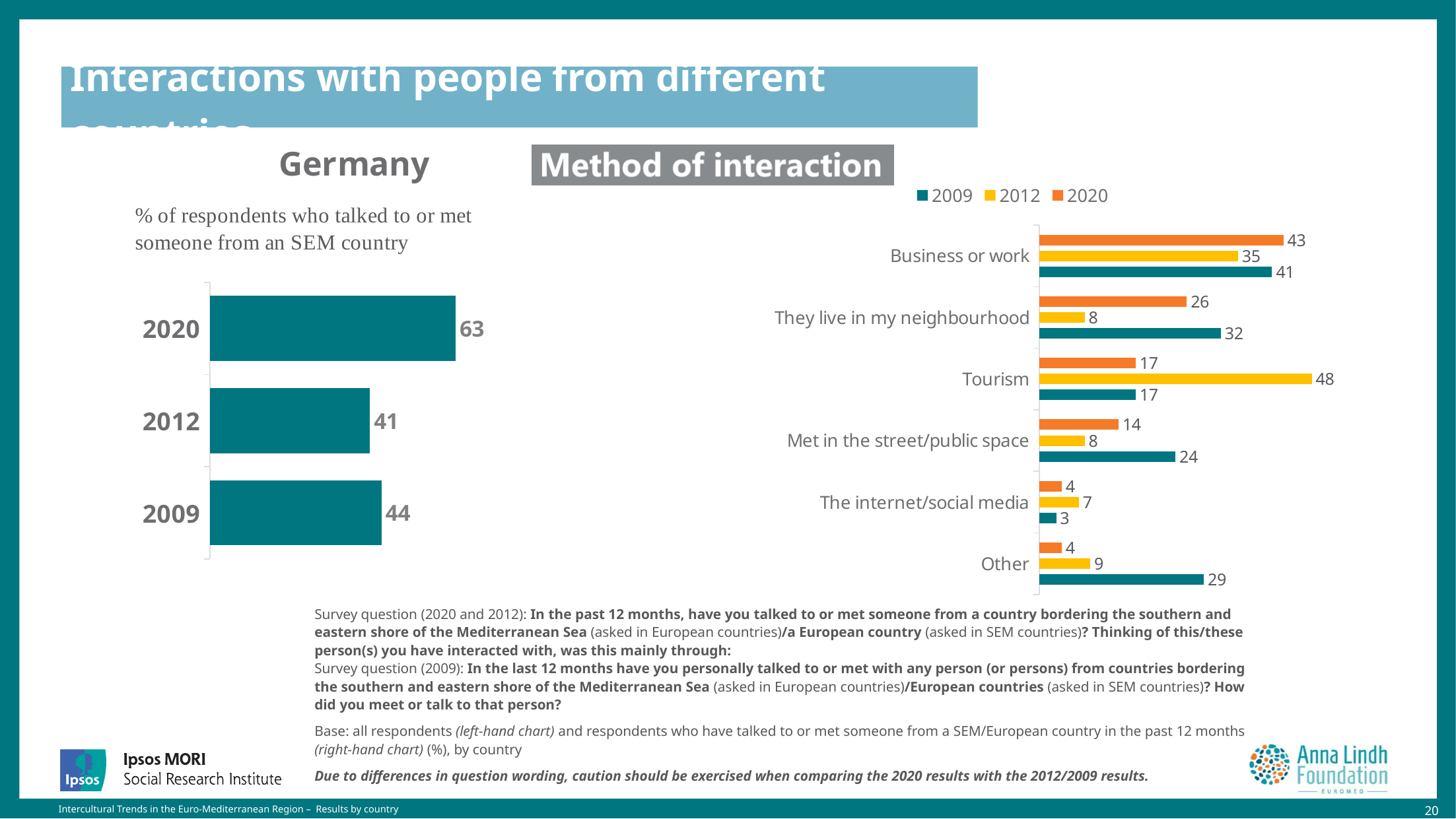
In the Method of interaction chart, which category has the highest 2020 value? Business or work In the Method of interaction chart, what is the 2009 value for They live in my neighbourhood? 32 In the left-hand chart (Germany), which year has the lowest value? 2012 In the left-hand chart (Germany), what percentage of respondents talked to or met someone from an SEM country in 2020? 63 How many series does the legend of the Method of interaction chart list? 3 In the Method of interaction chart, what is the 2012 value for Tourism? 48 What type of chart is the Method of interaction chart? Bar chart In the Method of interaction chart, which is larger for Met in the street/public space: the 2009 value or the 2020 value? 2009 In the Method of interaction chart, what is the difference between the 2009 and 2020 values for Other? 25 In the left-hand chart (Germany), what is the difference between the 2020 and 2012 values? 22 In the left-hand chart (Germany), how many years are shown? 3 In the Method of interaction chart, which category has the lowest 2009 value? The internet/social media